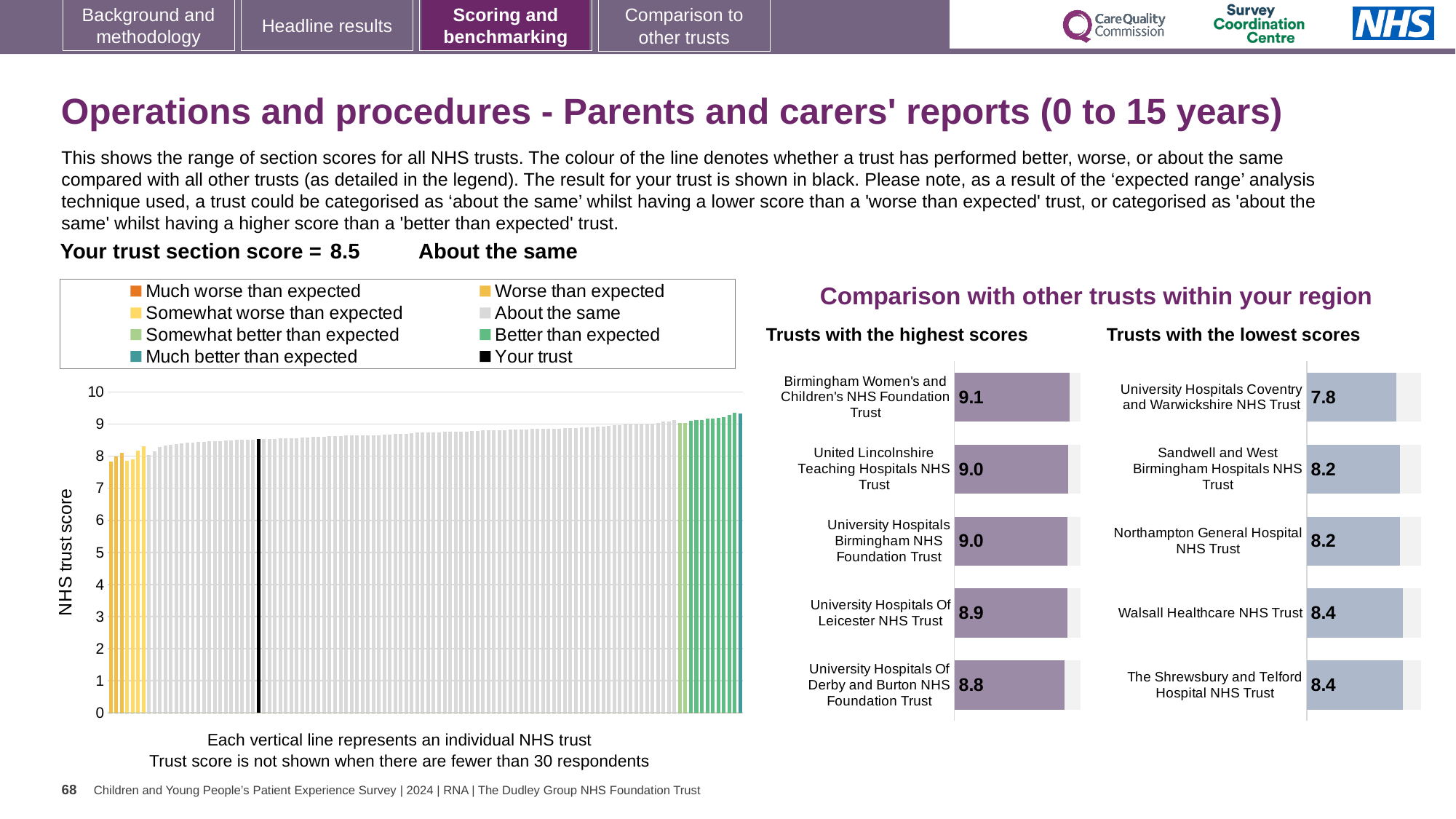
How many entries does the legend of the large chart on the left list? 8 In the 'Trusts with the lowest scores' chart, what is the score for University Hospitals Coventry and Warwickshire NHS Trust? 7.8 In the 'Trusts with the lowest scores' chart, what is the difference between the scores of The Shrewsbury and Telford Hospital NHS Trust and University Hospitals Coventry and Warwickshire NHS Trust? 0.6 In the 'Trusts with the highest scores' chart, which trust has the highest score? Birmingham Women's and Children's NHS Foundation Trust In the 'Trusts with the highest scores' chart, what is the difference between the scores of Birmingham Women's and Children's NHS Foundation Trust and University Hospitals Of Derby and Burton NHS Foundation Trust? 0.3 In the 'Trusts with the lowest scores' chart, which has the larger score: Walsall Healthcare NHS Trust or Sandwell and West Birmingham Hospitals NHS Trust? Walsall Healthcare NHS Trust How many trusts are listed in the 'Trusts with the highest scores' chart? 5 In the 'Trusts with the highest scores' chart, what is the score for Birmingham Women's and Children's NHS Foundation Trust? 9.1 In the 'Trusts with the lowest scores' chart, what is the score for Walsall Healthcare NHS Trust? 8.4 In the 'Trusts with the highest scores' chart, what is the score for University Hospitals Of Derby and Burton NHS Foundation Trust? 8.8 In the 'Trusts with the lowest scores' chart, which trust has the lowest score? University Hospitals Coventry and Warwickshire NHS Trust In the large chart on the left showing all NHS trusts, is the value for the black 'Your trust' bar greater or less than 8? greater